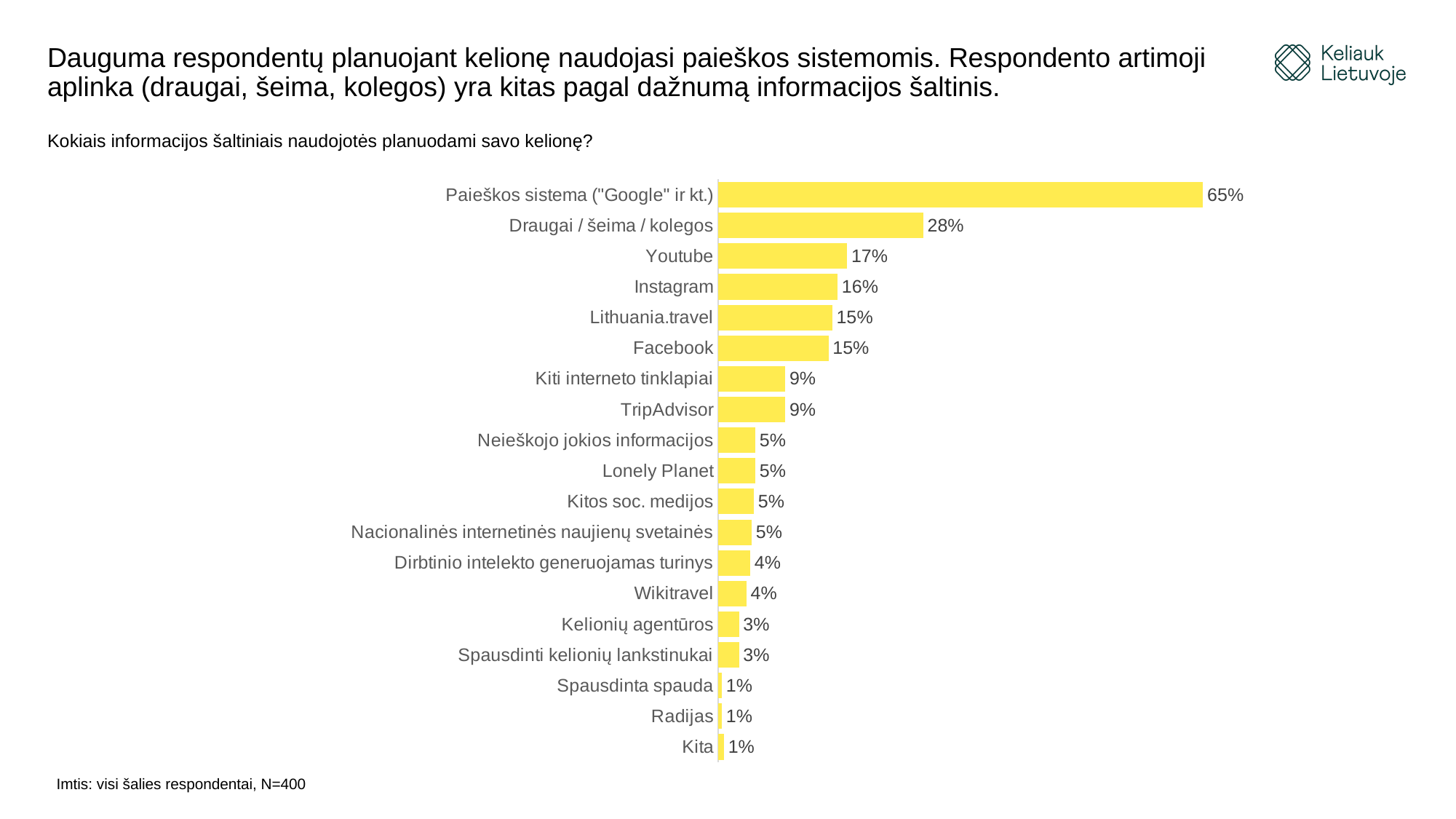
Which information source has the highest value? Paieškos sistema ("Google" ir kt.) What is the value for Dirbtinio intelekto generuojamas turinys? 4% What kind of chart is shown on the slide? Bar chart Which is larger, Instagram or Facebook? Instagram What is the sample size stated below the chart? N=400 What percentage of respondents used Paieškos sistema ("Google" ir kt.)? 65% How many information sources are listed in the chart? 19 What is the value for Draugai / šeima / kolegos? 28% What is the lowest value shown in the chart? 1% What is the value for TripAdvisor? 9% What is the difference between Paieškos sistema ("Google" ir kt.) and Draugai / šeima / kolegos? 37% What is the value for Youtube? 17%